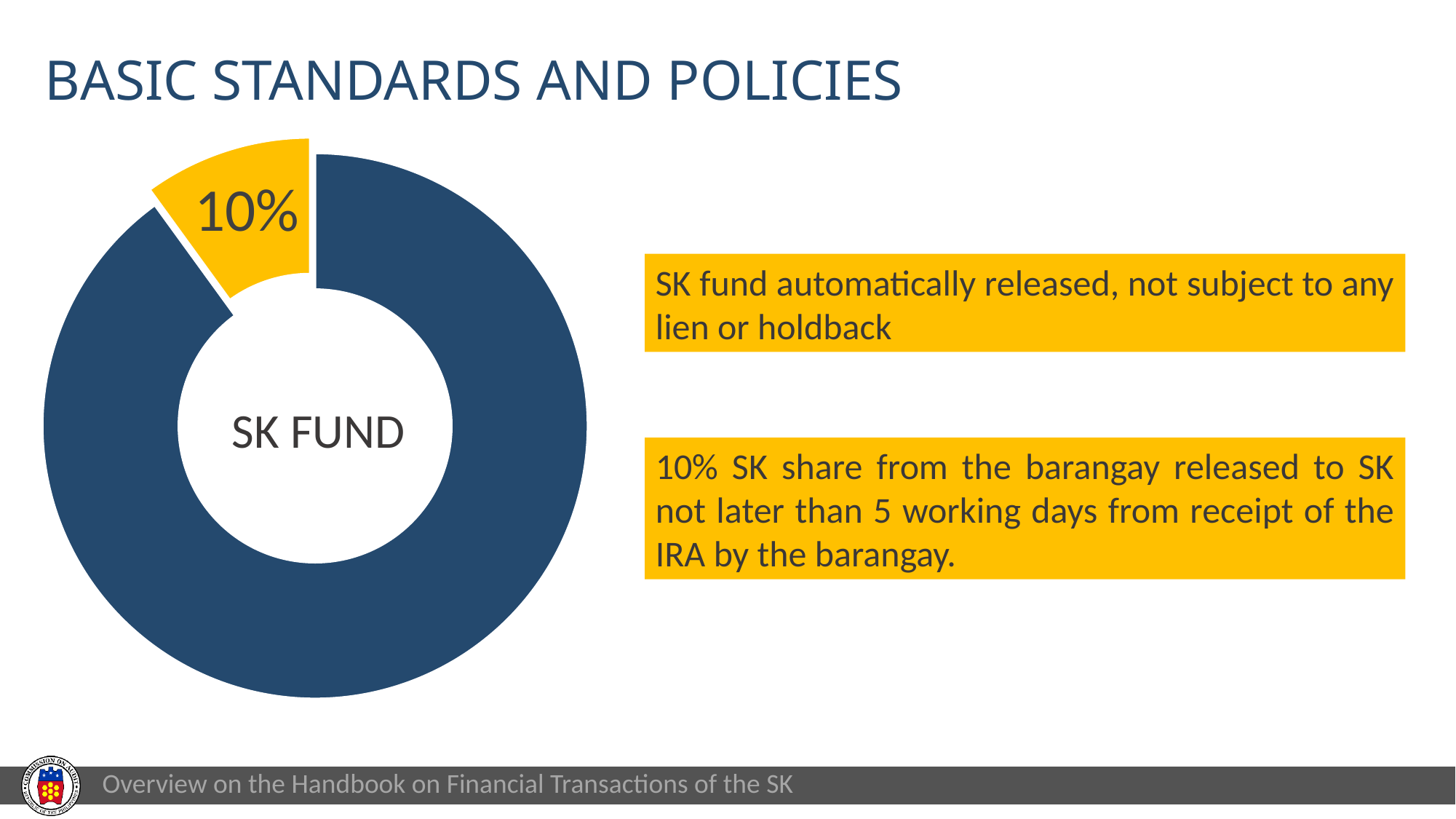
Which slice is the smallest in the doughnut chart? the yellow 10% slice What share of the doughnut chart does the yellow slice represent? 10% What kind of chart is shown on the slide? doughnut (pie) chart How many slices does the doughnut chart have? 2 Which slice is the largest in the doughnut chart? the dark blue slice Which slice of the doughnut chart is larger, the dark blue one or the yellow one? the dark blue one What percentage is printed on the yellow slice of the doughnut chart? 10% What text appears in the centre of the doughnut chart? SK FUND What colour is the slice labelled 10%? yellow Does the yellow slice take up more or less than half of the doughnut chart? less